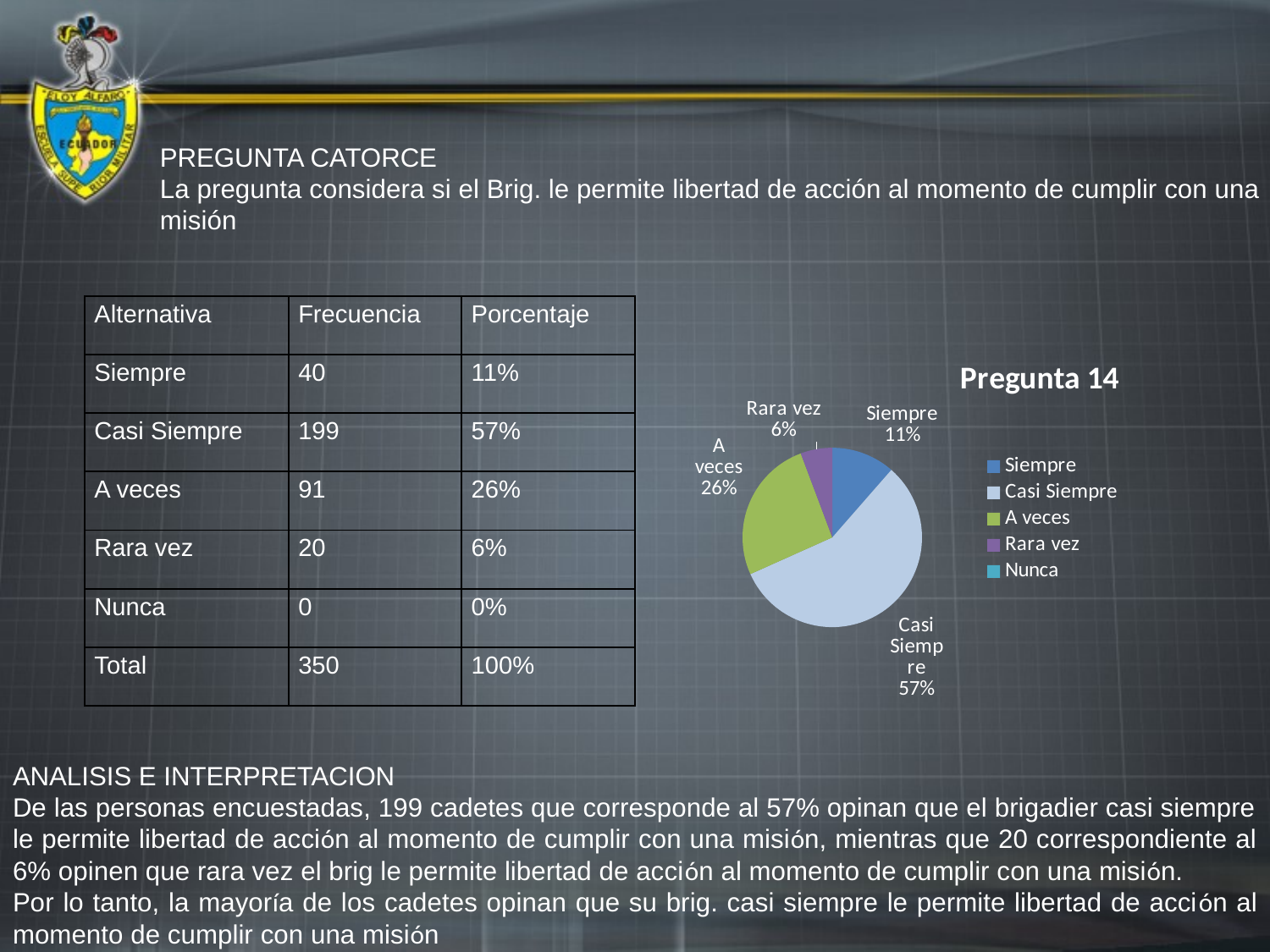
Which category has the largest slice in the pie chart? Casi Siempre What percentage does the 'Siempre' slice show? 11% What is the title of the chart? Pregunta 14 What percentage does the 'Rara vez' slice show? 6% What percentage does the 'Casi Siempre' slice show? 57% How many entries does the chart legend list? 5 Which slice is larger, 'Siempre' or 'A veces'? A veces What percentage does the 'A veces' slice show? 26% Which labelled slice in the pie chart is the smallest? Rara vez What type of chart is shown on the slide? pie chart What colour is the 'A veces' slice in the pie chart? green What is the difference in percentage points between the 'Casi Siempre' and 'A veces' slices? 31